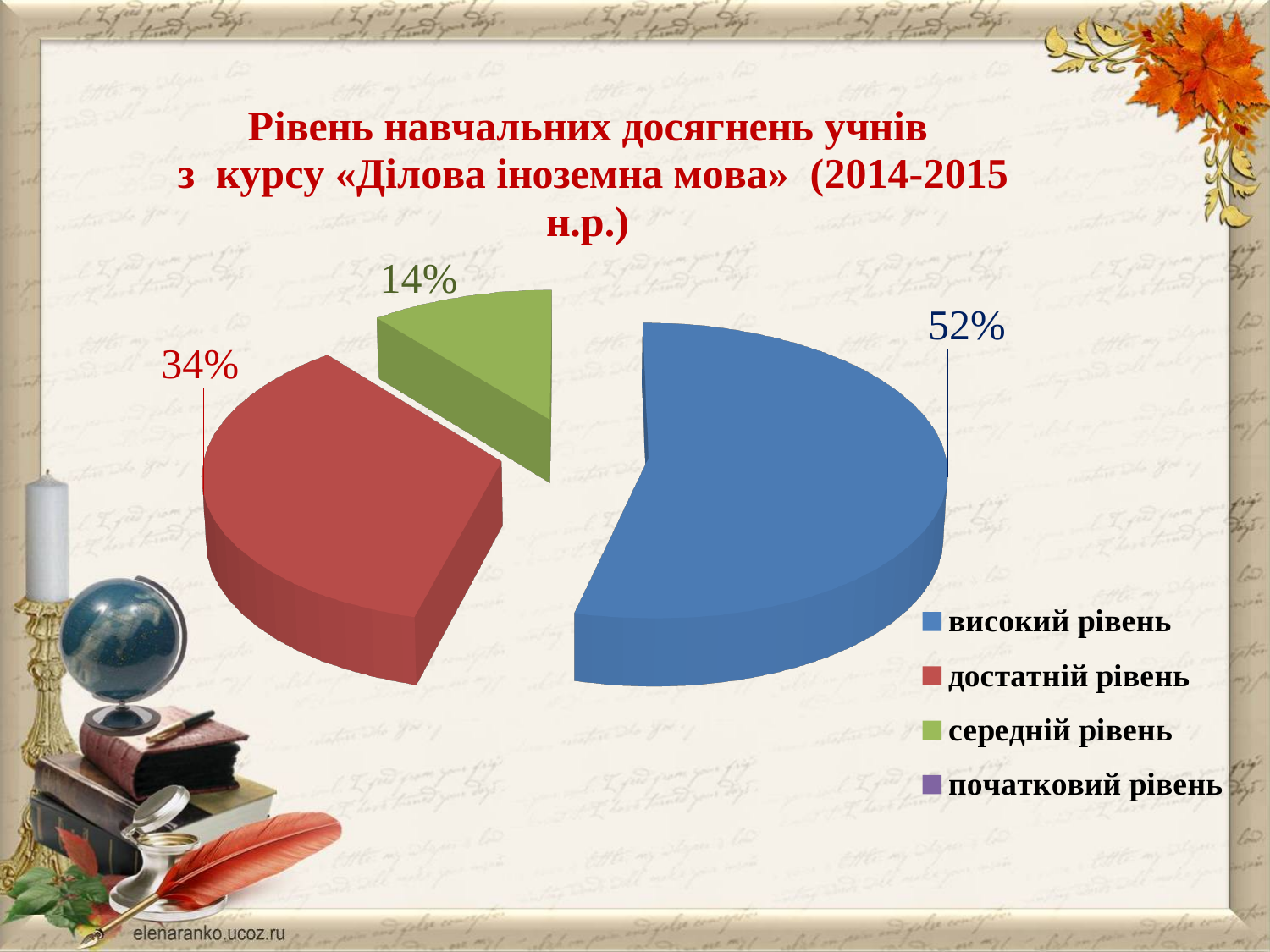
What colour is the slice for "високий рівень"? blue Which is larger, the slice for "достатній рівень" or the slice for "середній рівень"? достатній рівень How many entries does the legend list? 4 What is the difference in percentage points between "високий рівень" and "достатній рівень"? 18% What share of the pie does "високий рівень" have? 52% Which category has the largest slice of the pie? високий рівень What share of the pie does "достатній рівень" have? 34% Which of the labelled slices is the smallest? середній рівень What kind of chart is shown on the slide? pie chart How many slices with percentage labels are visible in the pie? 3 What is the difference in percentage points between "достатній рівень" and "середній рівень"? 20% What share of the pie does "середній рівень" have? 14%